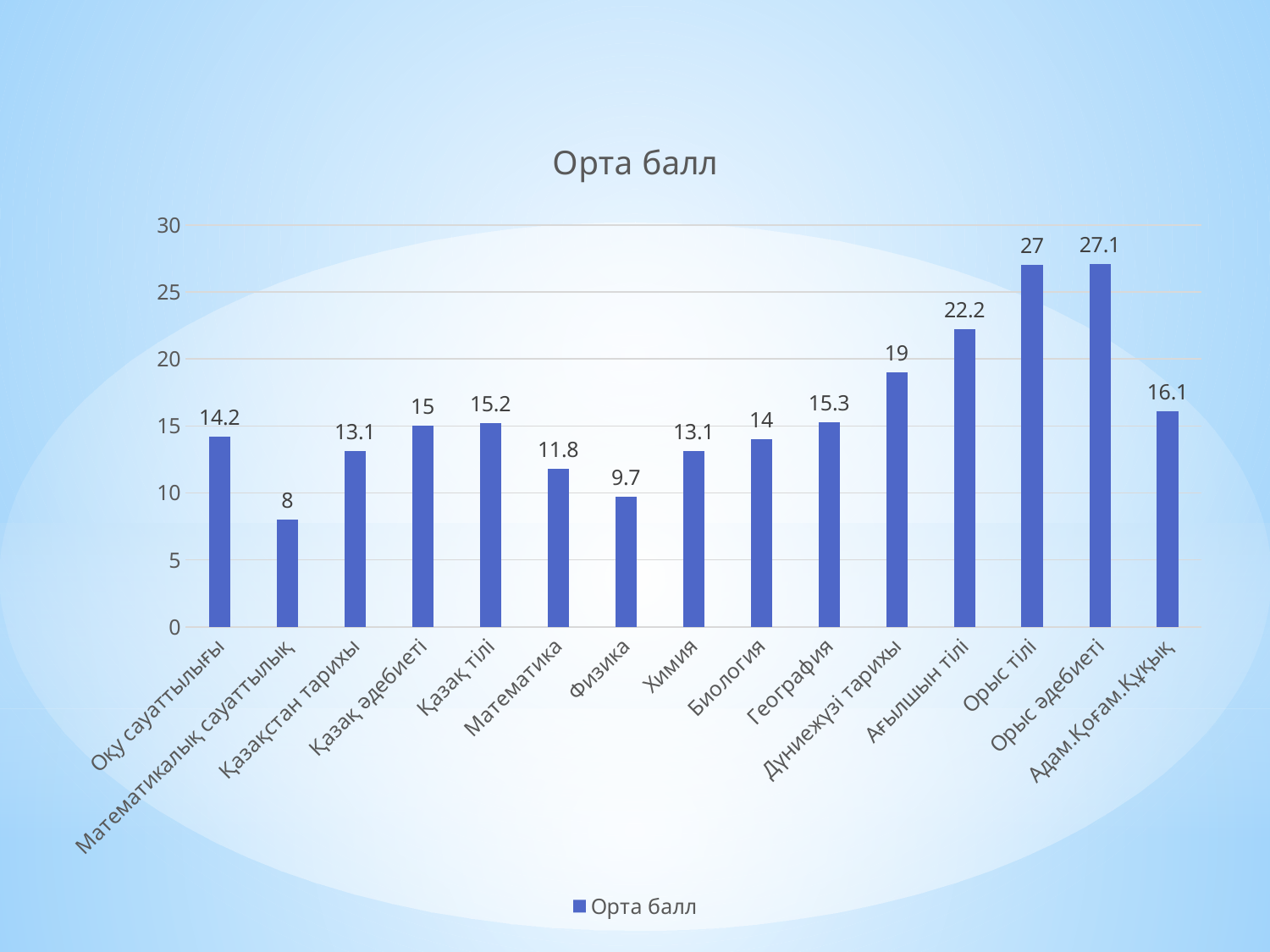
What kind of chart is this? Bar chart Is the value for Қазақ тілі greater or less than 15? greater Which category has the highest value? Орыс әдебиеті What is the title of the chart? Орта балл What is the value for Физика? 9.7 What is the value for Ағылшын тілі? 22.2 What is the value for Математика? 11.8 What is the difference between the values for Орыс тілі and Дүниежүзі тарихы? 8 What is the value for Адам.Қоғам.Құқық? 16.1 Which category has the lowest value? Математикалық сауаттылық How many categories are shown on the x axis? 15 Which is larger, the value for География or the value for Биология? География